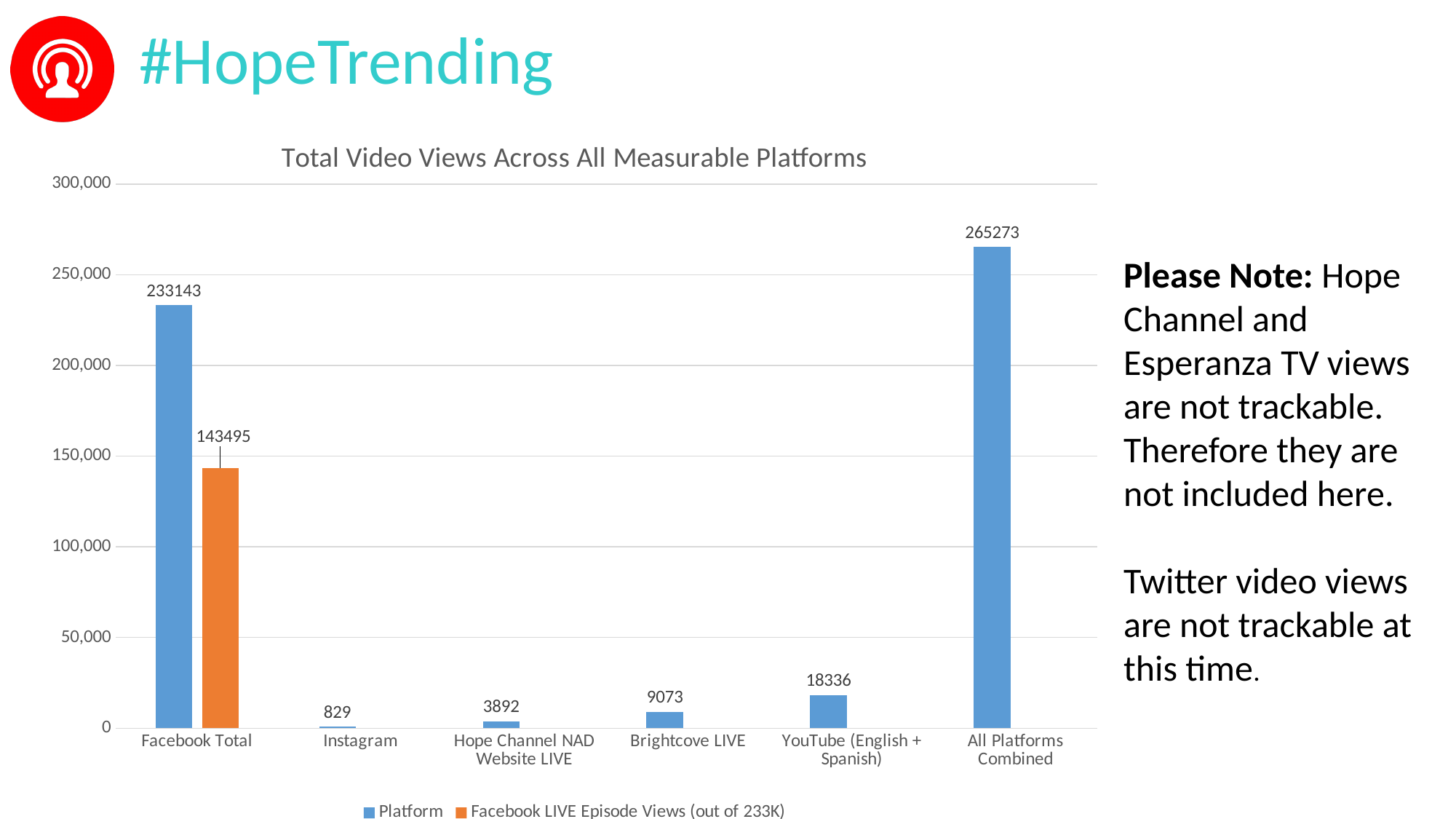
Which category has the lowest value? Instagram What is the value for All Platforms Combined? 265273 Is the value for Facebook Total greater or less than 200,000? greater What is the difference between Brightcove LIVE and Hope Channel NAD Website LIVE? 5181 Which category has the highest value? All Platforms Combined What is the value for YouTube (English + Spanish)? 18336 How many series does the legend list? 2 What is the value of the Facebook LIVE Episode Views bar? 143495 What is the value for Facebook Total in the Platform series? 233143 What type of chart is shown? Bar chart How many categories are shown on the x axis? 6 Which is larger, YouTube (English + Spanish) or Brightcove LIVE? YouTube (English + Spanish)